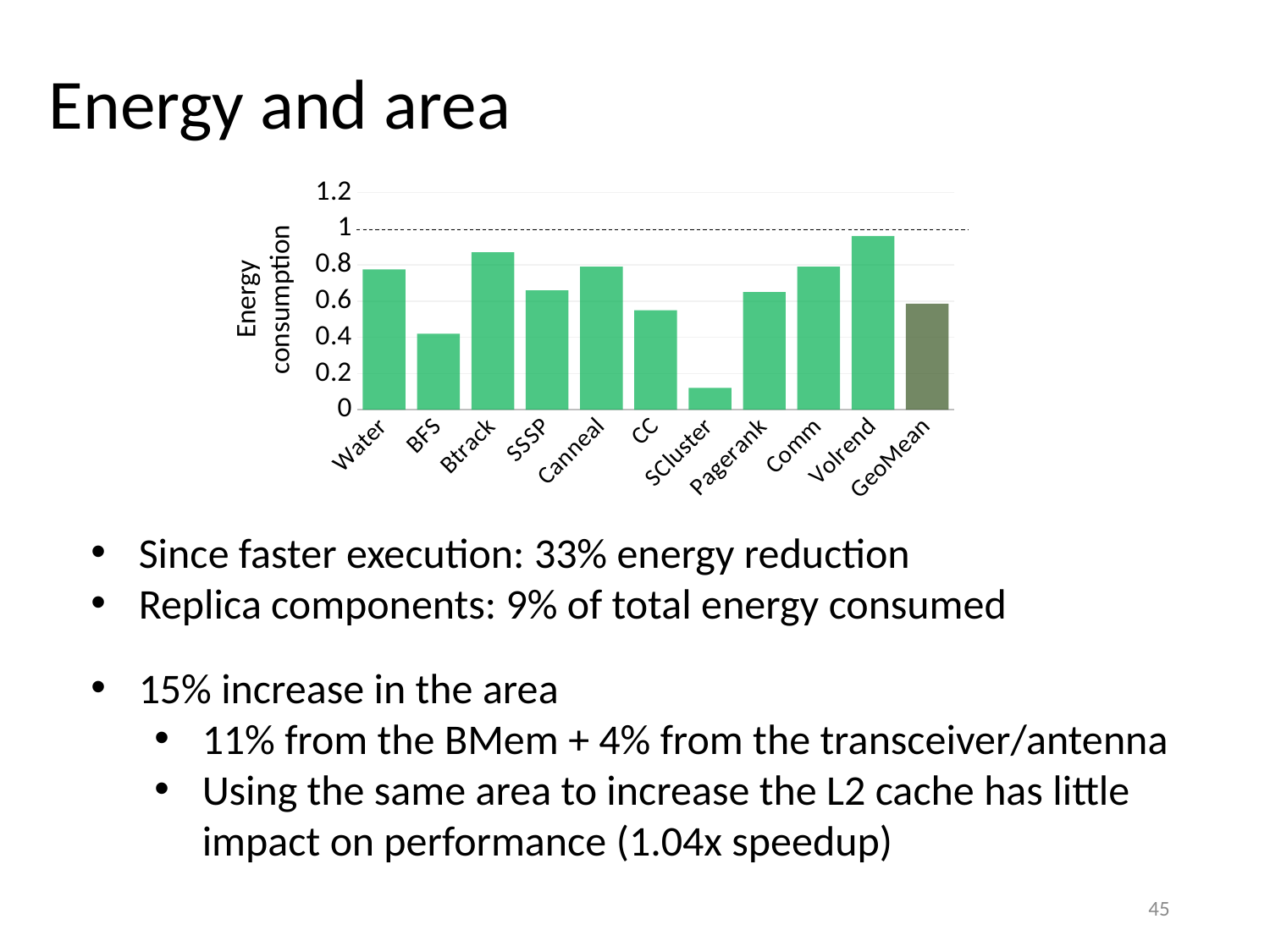
Which category has the highest energy consumption in the chart? Volrend What kind of chart is shown on the slide? bar chart Is the value for SCluster greater or less than 0.2? less Which has the larger energy consumption, Btrack or BFS? Btrack Is the value for GeoMean greater or less than 0.8? less Is the value for BFS greater or less than 0.6? less Which category has the lowest energy consumption in the chart? SCluster What is the label of the vertical axis of the chart? Energy consumption How many categories are shown on the x axis of the chart? 11 Which has the larger energy consumption, CC or Volrend? Volrend